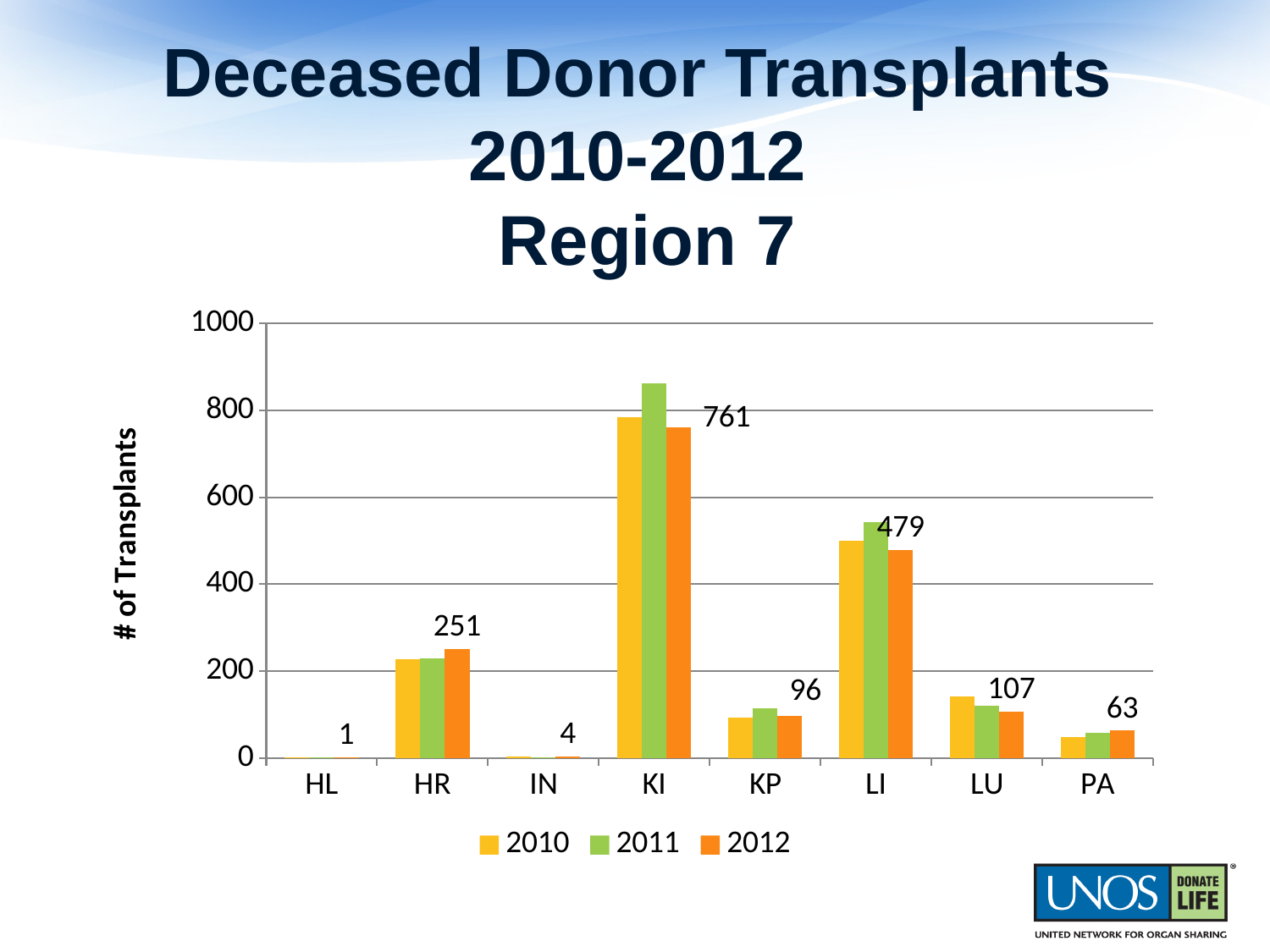
How many categories are shown on the x axis? 8 What kind of chart is shown on the slide? Bar chart What is the value for LI in 2012? 479 What is the value for HR in 2012? 251 Is the value for KI in 2011 greater or less than 800? greater Which is larger in 2012, LU or KP? LU How many series does the legend list? 3 Which category has the lowest value in 2012? HL What is the value for KI in 2012? 761 What is the value for PA in 2012? 63 What is the difference between the 2012 values for KI and LI? 282 Which category has the highest value in 2012? KI